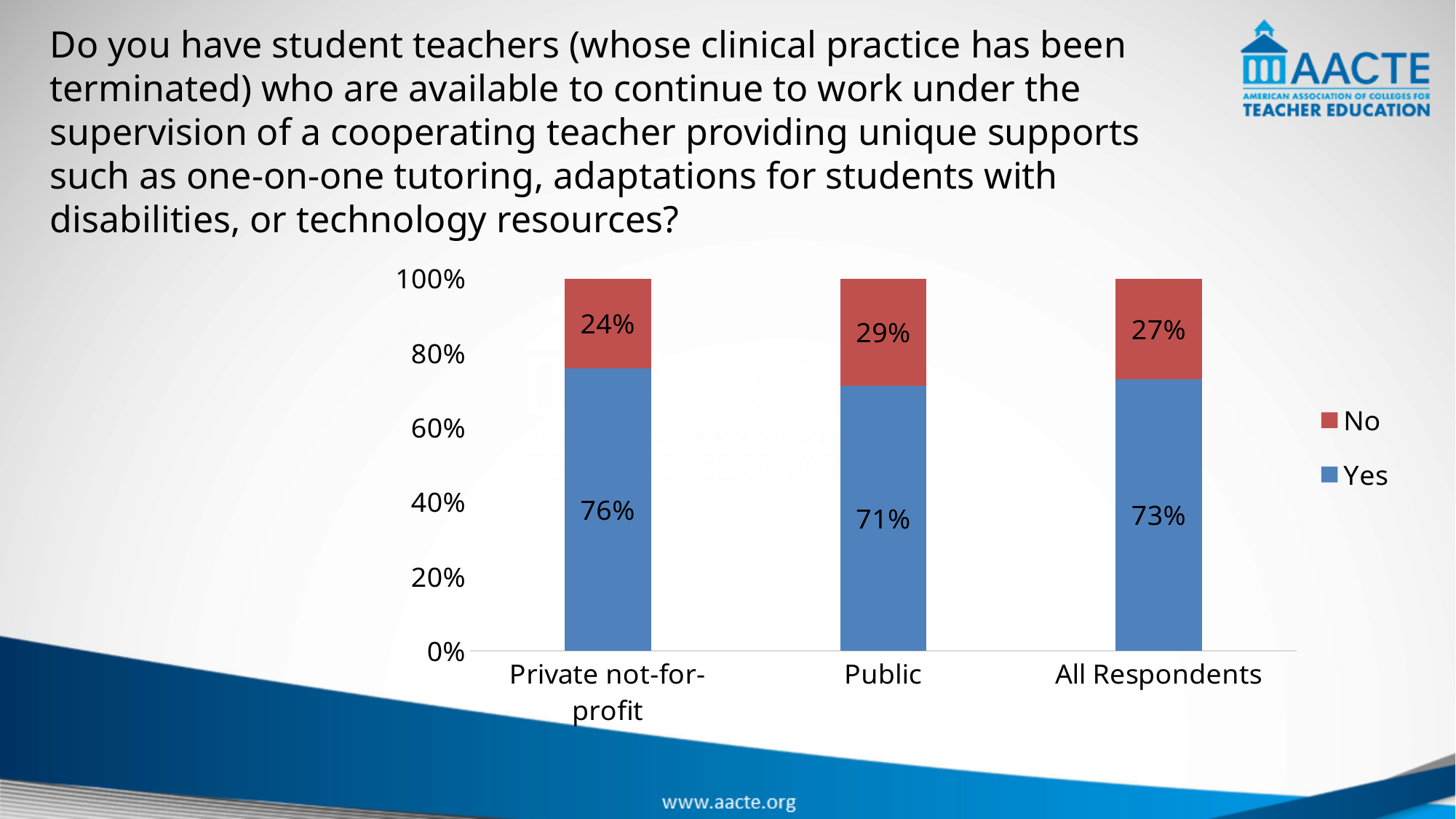
What is the Yes value for All Respondents? 73% What kind of chart is shown on the slide? Stacked bar chart What is the difference between the Yes percentages for Private not-for-profit and Public? 5% Which category has the highest Yes percentage? Private not-for-profit Which category has the lowest Yes percentage? Public Which colour represents the Yes responses in the chart? Blue Which is larger, the No percentage for Public or the No percentage for All Respondents? Public How many series does the legend list? 2 What percentage of Public respondents answered No? 29% How many categories are shown on the x axis? 3 What is the No value for Private not-for-profit? 24% What percentage of Private not-for-profit respondents answered Yes? 76%